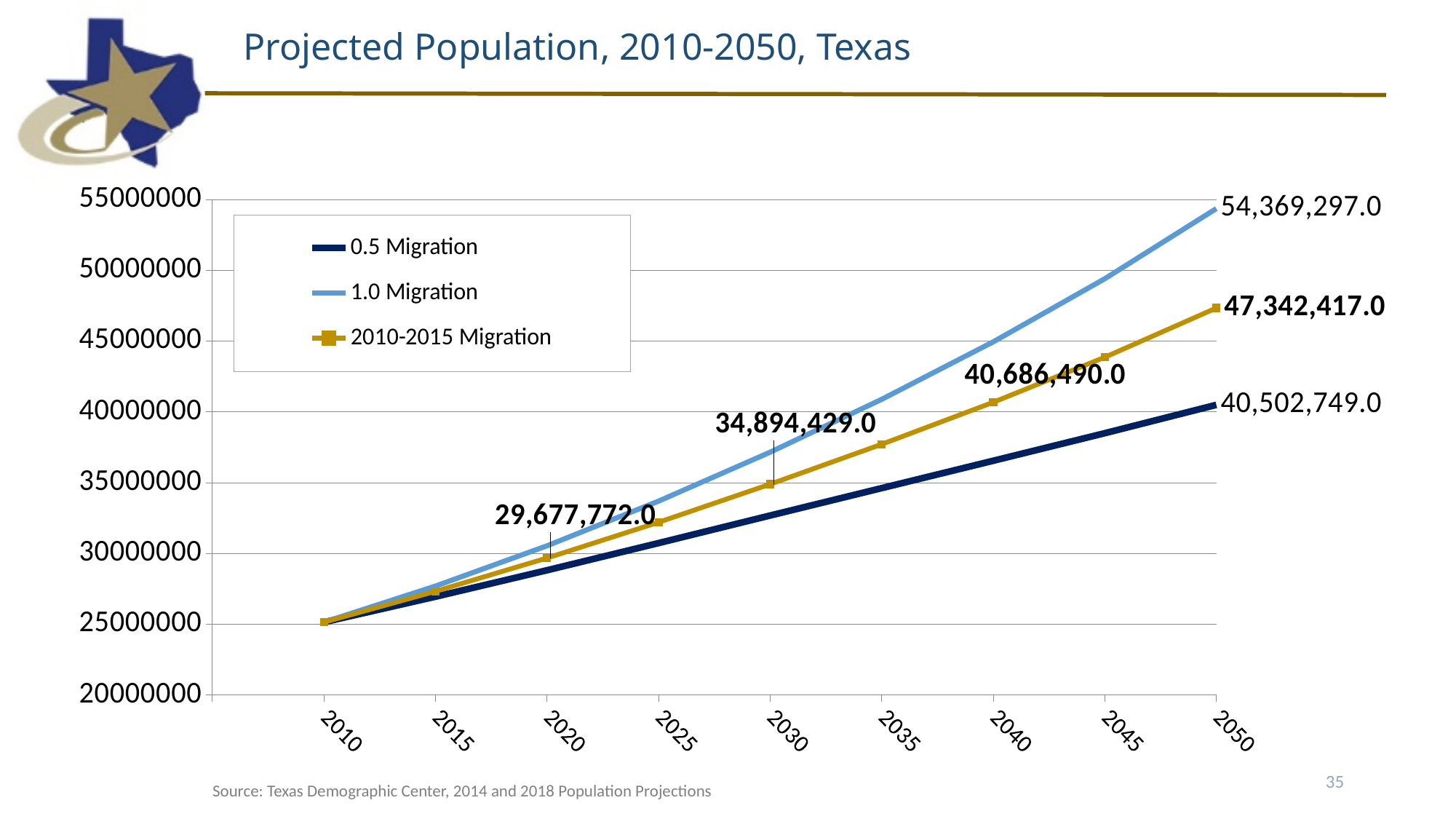
What is the labelled value for the 2010-2015 Migration series in 2020? 29,677,772.0 What is the labelled value for the 2010-2015 Migration series in 2030? 34,894,429.0 What type of chart is shown on the slide? line chart How many years are marked along the x axis? 9 What is the projected population for the 0.5 Migration series in 2050? 40,502,749.0 Which series has the highest projected population in 2050? 1.0 Migration What is the projected population for the 1.0 Migration series in 2050? 54,369,297.0 What is the projected population for the 2010-2015 Migration series in 2050? 47,342,417.0 How many series does the legend list? 3 Is the 2010-2015 Migration value in 2040 greater or less than 40000000? greater Which series has the lowest projected population in 2050? 0.5 Migration What is the difference between the 1.0 Migration and 0.5 Migration values in 2050? 13,866,548.0